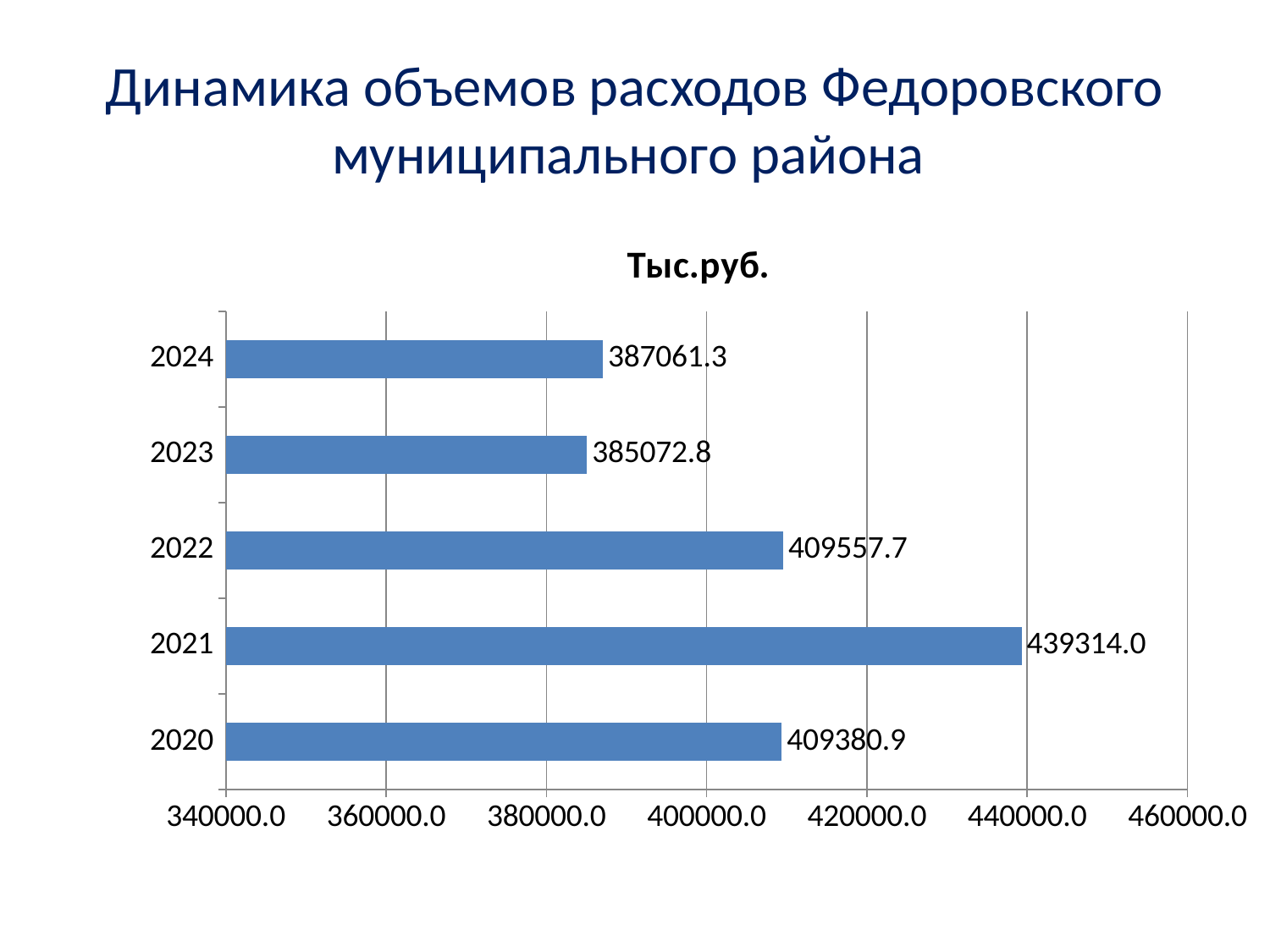
What is the value for 2021? 439314.0 What is the value for 2020? 409380.9 Which is larger, the value for 2021 or the value for 2023? 2021 How many years are shown in the chart? 5 What is the value for 2024? 387061.3 What type of chart is shown on the slide? bar chart Is the value for 2024 greater or less than 400000.0? less Which year has the highest value? 2021 Which year has the lowest value? 2023 What is the value for 2023? 385072.8 What is the difference between the values for 2021 and 2020? 29933.1 What is the difference between the values for 2024 and 2023? 1988.5